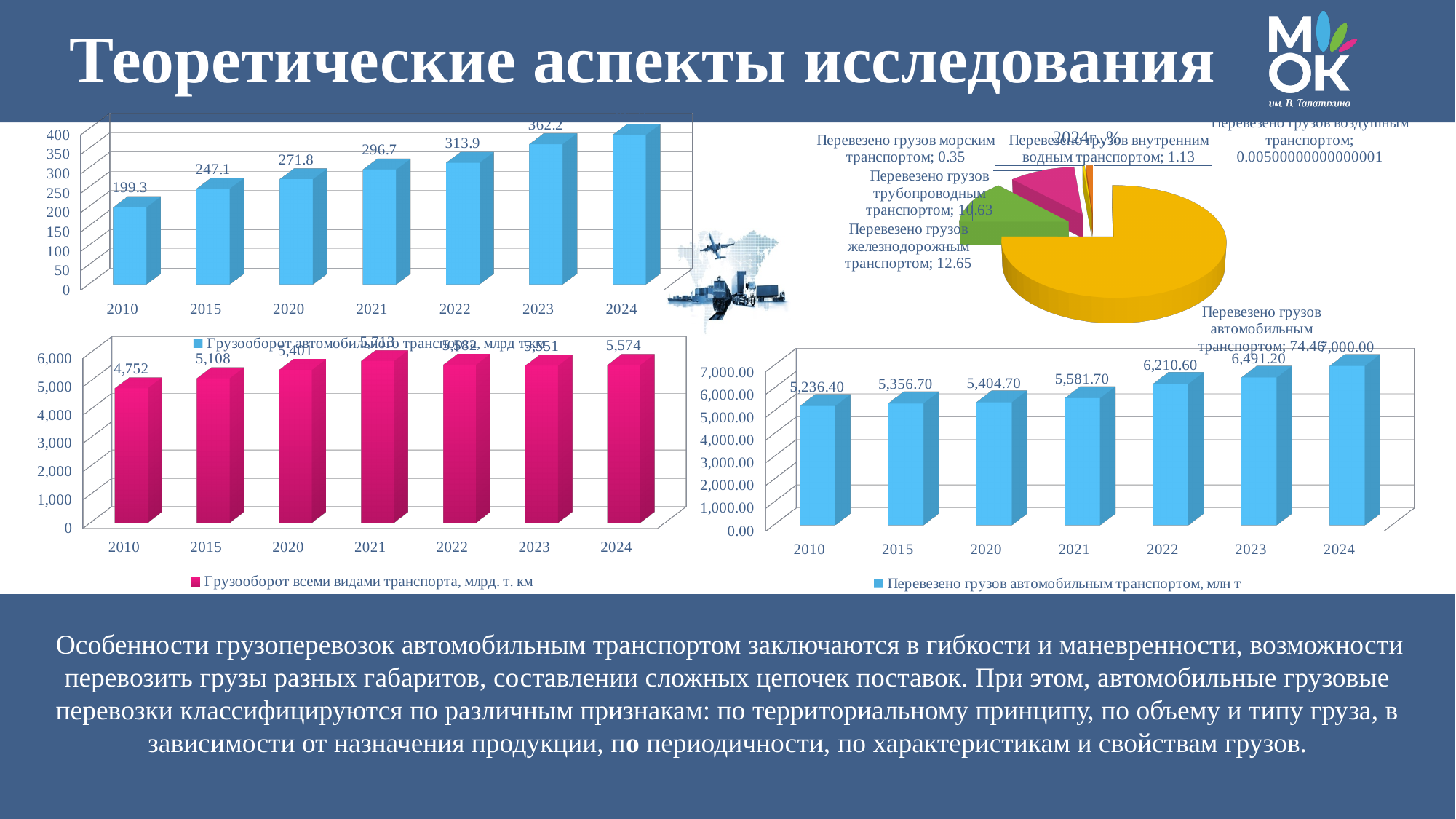
In the bottom-right chart 'Перевезено грузов автомобильным транспортом, млн т', which year has the highest value? 2024 In the top-left bar chart, what is the value for 2022? 313.9 In the top-left bar chart, do the values rise or fall from 2010 to 2024? rise In the pie chart '2024г, %', what share is shown for 'Перевезено грузов железнодорожным транспортом'? 12.65 In the bottom-right chart 'Перевезено грузов автомобильным транспортом, млн т', what is the value for 2023? 6,491.20 In the bottom-left chart 'Грузооборот всеми видами транспорта, млрд. т. км', how many years are shown on the x axis? 7 In the pie chart '2024г, %', what share is shown for 'Перевезено грузов морским транспортом'? 0.35 In the bottom-left chart 'Грузооборот всеми видами транспорта, млрд. т. км', which year has the lowest value? 2010 In the top-left bar chart, what is the difference between the values for 2021 and 2015? 49.6 In the bottom-right chart 'Перевезено грузов автомобильным транспортом, млн т', which is larger, the value for 2022 or the value for 2021? 2022 In the top-left bar chart, what is the value for 2010? 199.3 In the bottom-left chart 'Грузооборот всеми видами транспорта, млрд. т. км', what is the value for 2010? 4,752